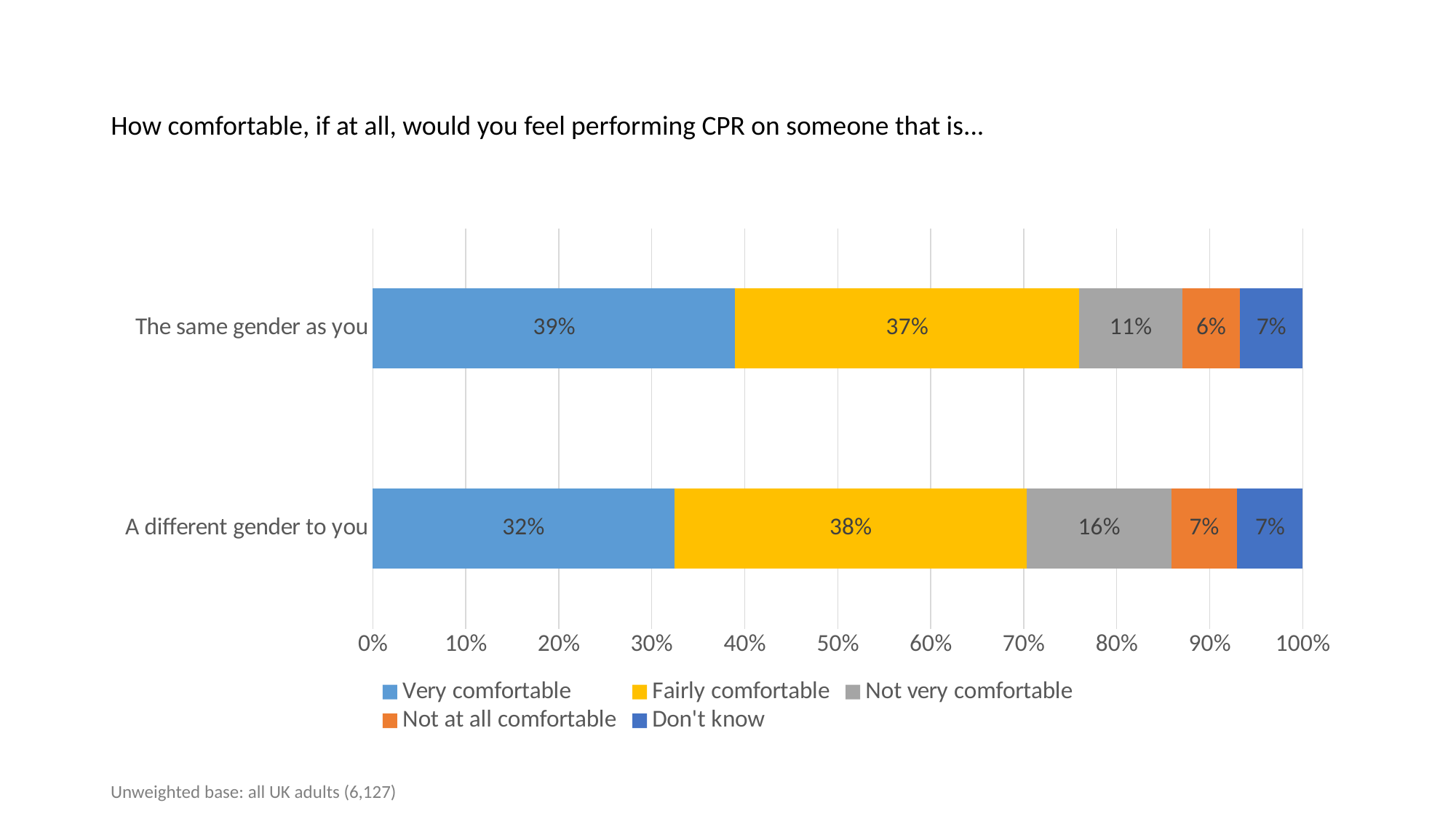
Which category has the higher 'Very comfortable' value? The same gender as you What is the 'Fairly comfortable' value for 'A different gender to you'? 38% What kind of chart is shown on the slide? Stacked bar chart What percentage said they would be not very comfortable performing CPR on someone of a different gender to them? 16% How many categories are shown on the chart? 2 What is the difference between the 'Very comfortable' values for the same gender and a different gender? 7 percentage points Which category has the lower 'Not very comfortable' value? The same gender as you Is the 'Not very comfortable' value larger for 'The same gender as you' or 'A different gender to you'? A different gender to you How many series does the legend list? 5 What colour represents 'Don't know' in the chart? Dark blue What percentage of respondents said they would be very comfortable performing CPR on someone of the same gender as them? 39% What is the 'Not at all comfortable' value for 'The same gender as you'? 6%